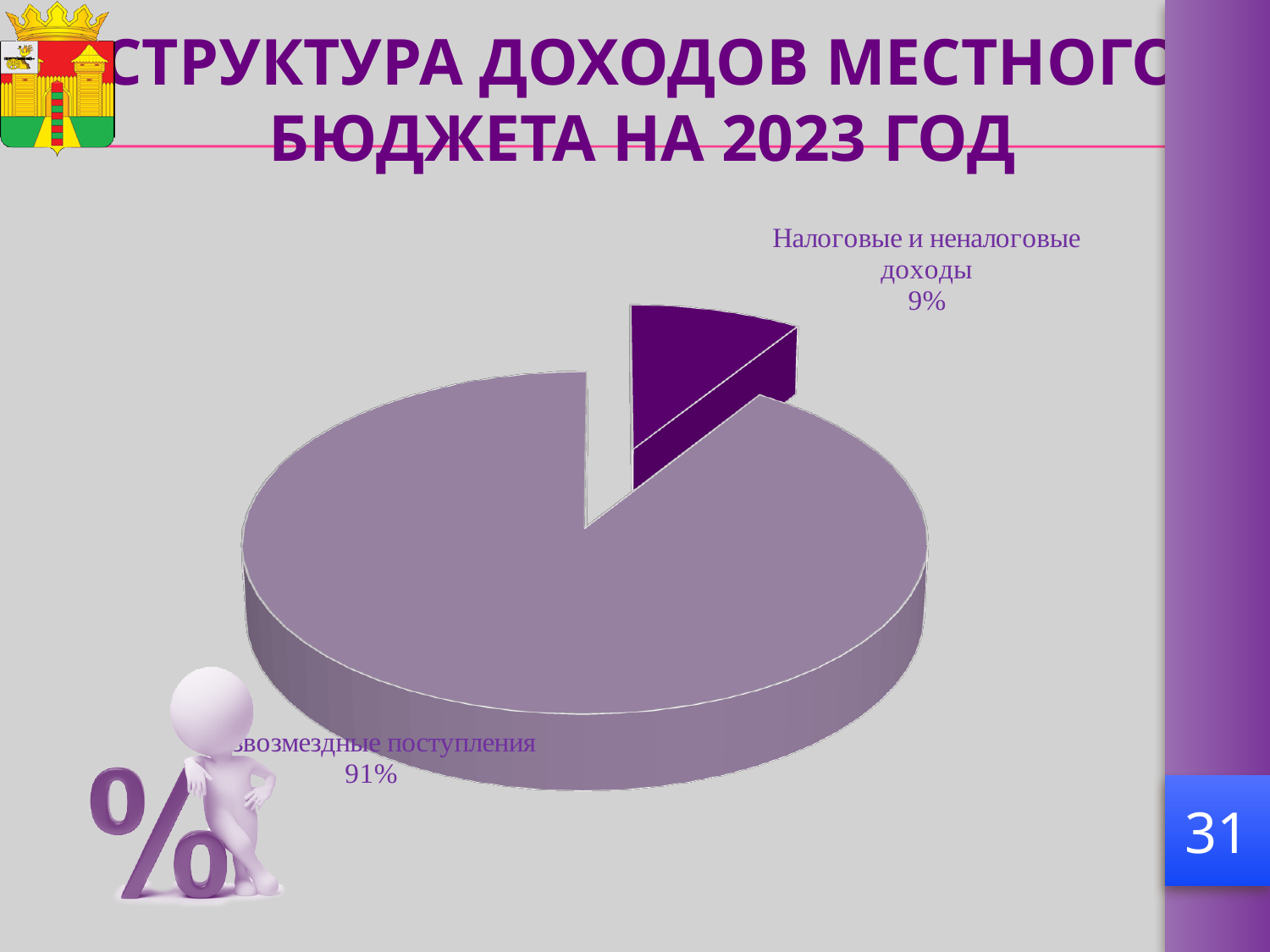
How many slices does the pie chart have? 2 What type of chart is shown on the slide? Pie chart Which slice of the pie is pulled out (exploded) from the rest? Налоговые и неналоговые доходы What is the difference in percentage points between "Безвозмездные поступления" and "Налоговые и неналоговые доходы"? 82 Which is larger: the share of "Налоговые и неналоговые доходы" or the share of "Безвозмездные поступления"? Безвозмездные поступления What is the title of the slide containing the pie chart? СТРУКТУРА ДОХОДОВ МЕСТНОГО БЮДЖЕТА НА 2023 ГОД What share of the pie does "Налоговые и неналоговые доходы" have? 9% What share of the pie does "Безвозмездные поступления" have? 91% Which category has the largest share of the pie? Безвозмездные поступления Which category has the smallest share of the pie? Налоговые и неналоговые доходы